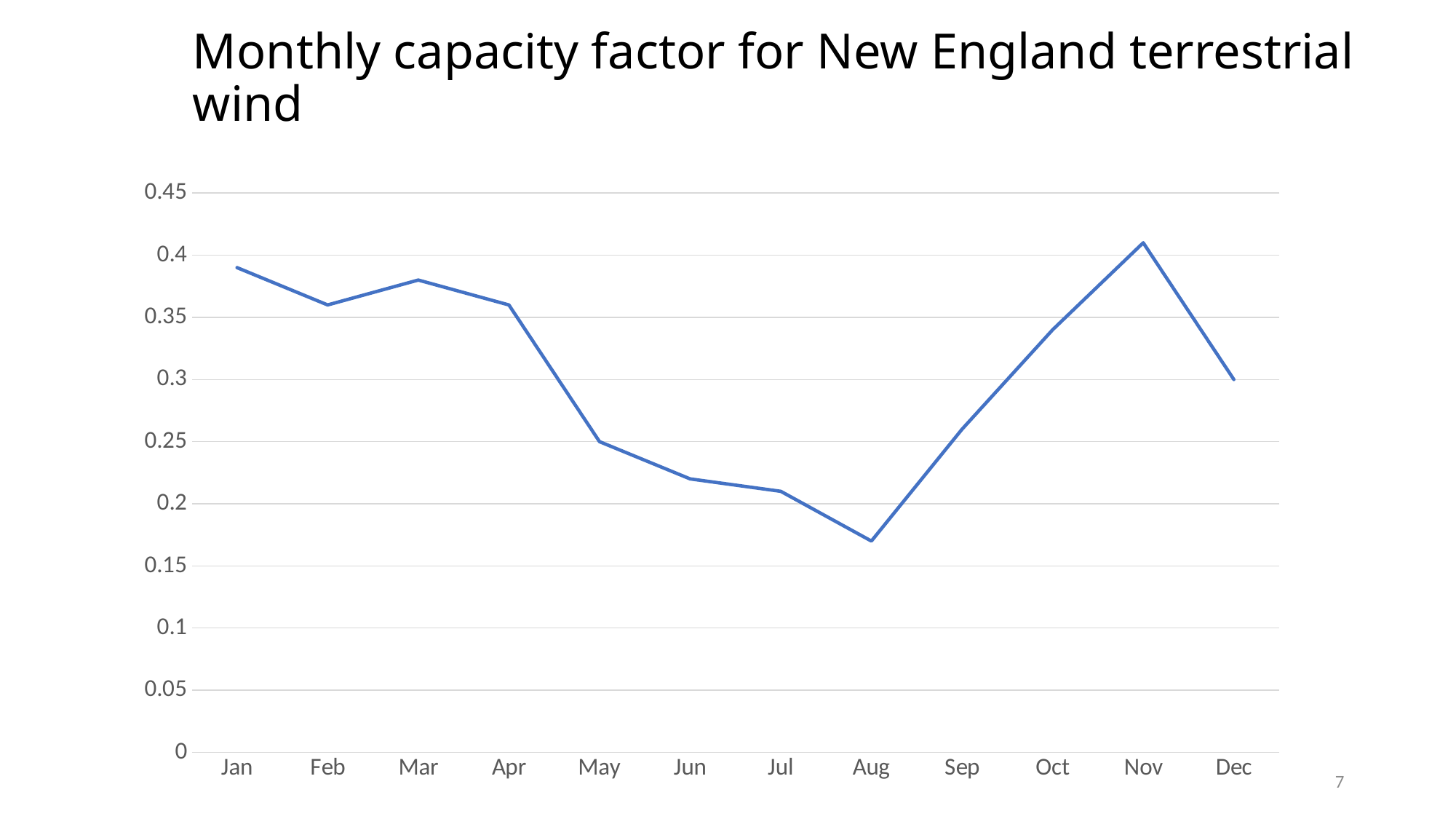
Which month has a higher capacity factor, Jan or Feb? Jan Is the value for Nov greater or less than 0.4? greater What is the title of the chart? Monthly capacity factor for New England terrestrial wind What is the capacity factor for May? 0.25 Is the value for Aug greater or less than 0.2? less Is the value for Jan greater or less than 0.35? greater What kind of chart is shown on the slide? line chart Does the capacity factor rise or fall from Apr to Aug? fall Which month has the lowest capacity factor? Aug What is the capacity factor for Dec? 0.3 Which month has the highest capacity factor? Nov How many months are plotted on the x axis? 12